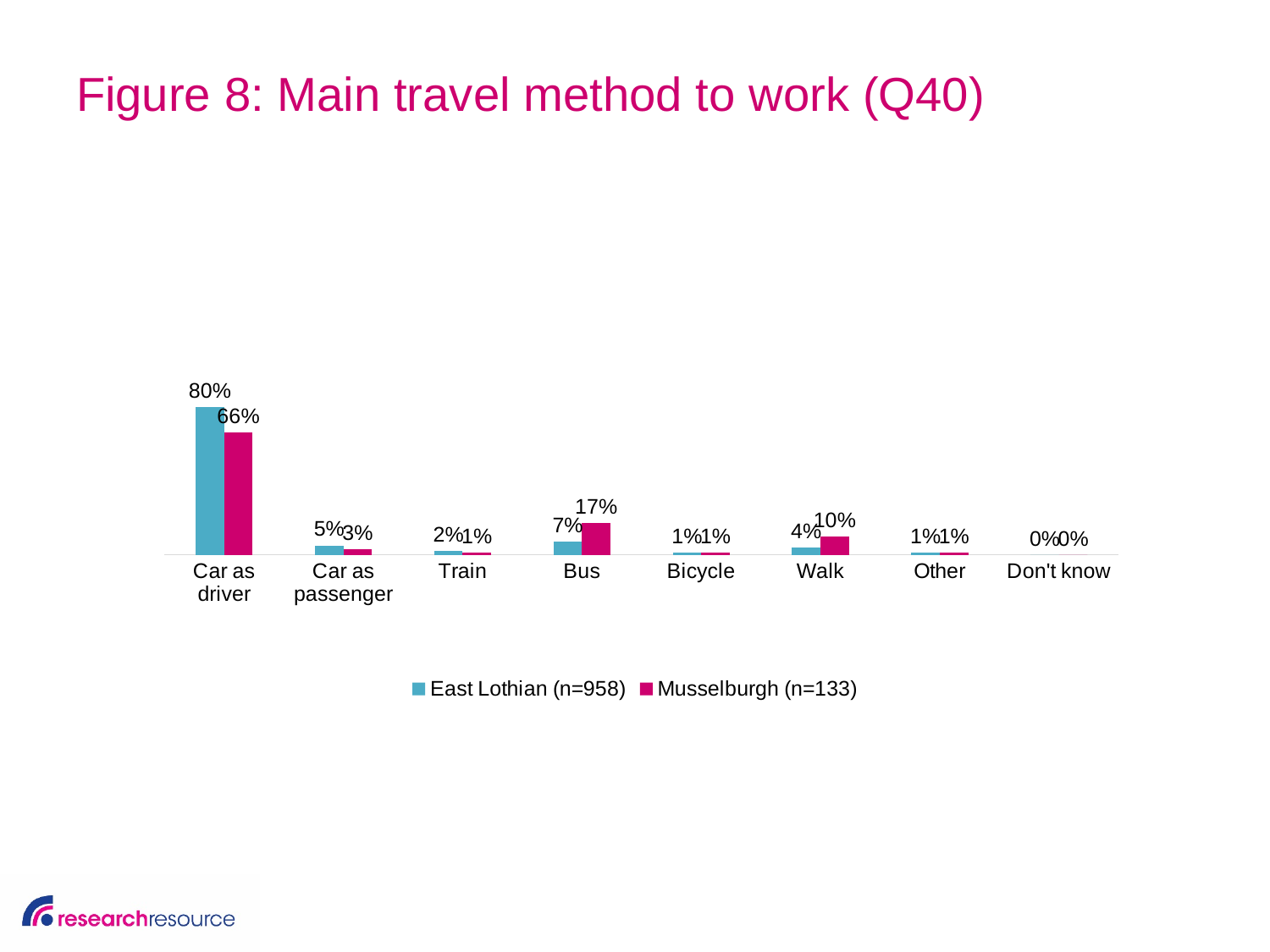
Which category has the lowest value for East Lothian? Don't know Which is larger for Car as passenger: East Lothian or Musselburgh? East Lothian What is the difference between the Musselburgh and East Lothian values for Bus? 10% What kind of chart is shown on the slide? Bar chart What is the Musselburgh value for Bus? 17% How many series does the legend list? 2 What is the difference between the East Lothian and Musselburgh values for Car as driver? 14% How many travel method categories are shown on the x axis? 8 Which category has the highest value for Musselburgh? Car as driver Which is larger for Walk: East Lothian or Musselburgh? Musselburgh What is the East Lothian value for Car as driver? 80% What is the Musselburgh value for Walk? 10%